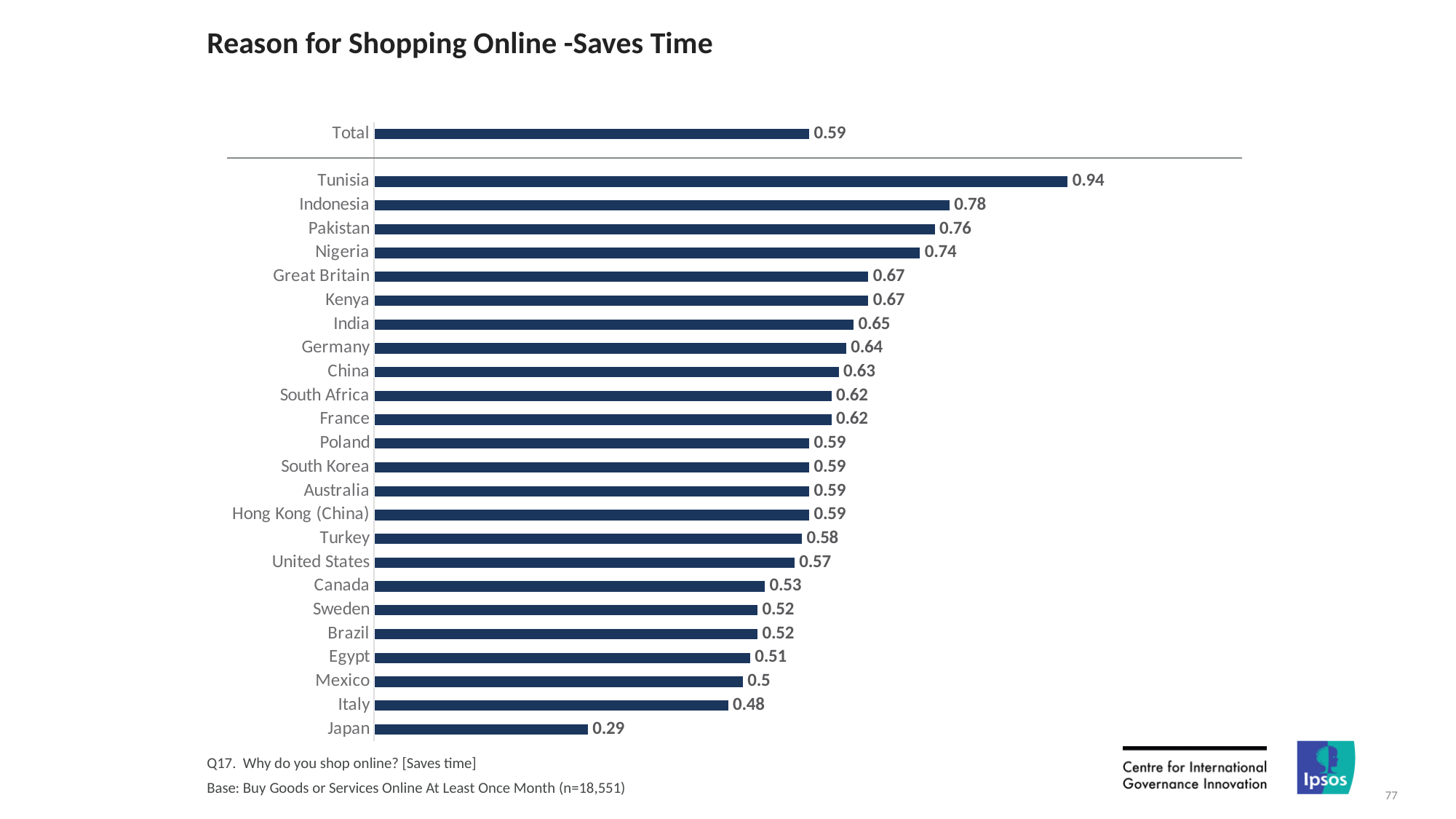
What is the value for Japan? 0.29 How many countries (excluding Total) are shown in the chart? 23 What is the difference between the values for Indonesia and Pakistan? 0.02 What is the value for Tunisia? 0.94 Which country has the highest value? Tunisia What is the value for Germany? 0.64 What is the difference between the values for Tunisia and Japan? 0.65 What is the value for Total? 0.59 Which country has the lowest value? Japan Which has a larger value, Canada or United States? United States What kind of chart is shown on the slide? Bar chart Which has a larger value, Nigeria or Kenya? Nigeria